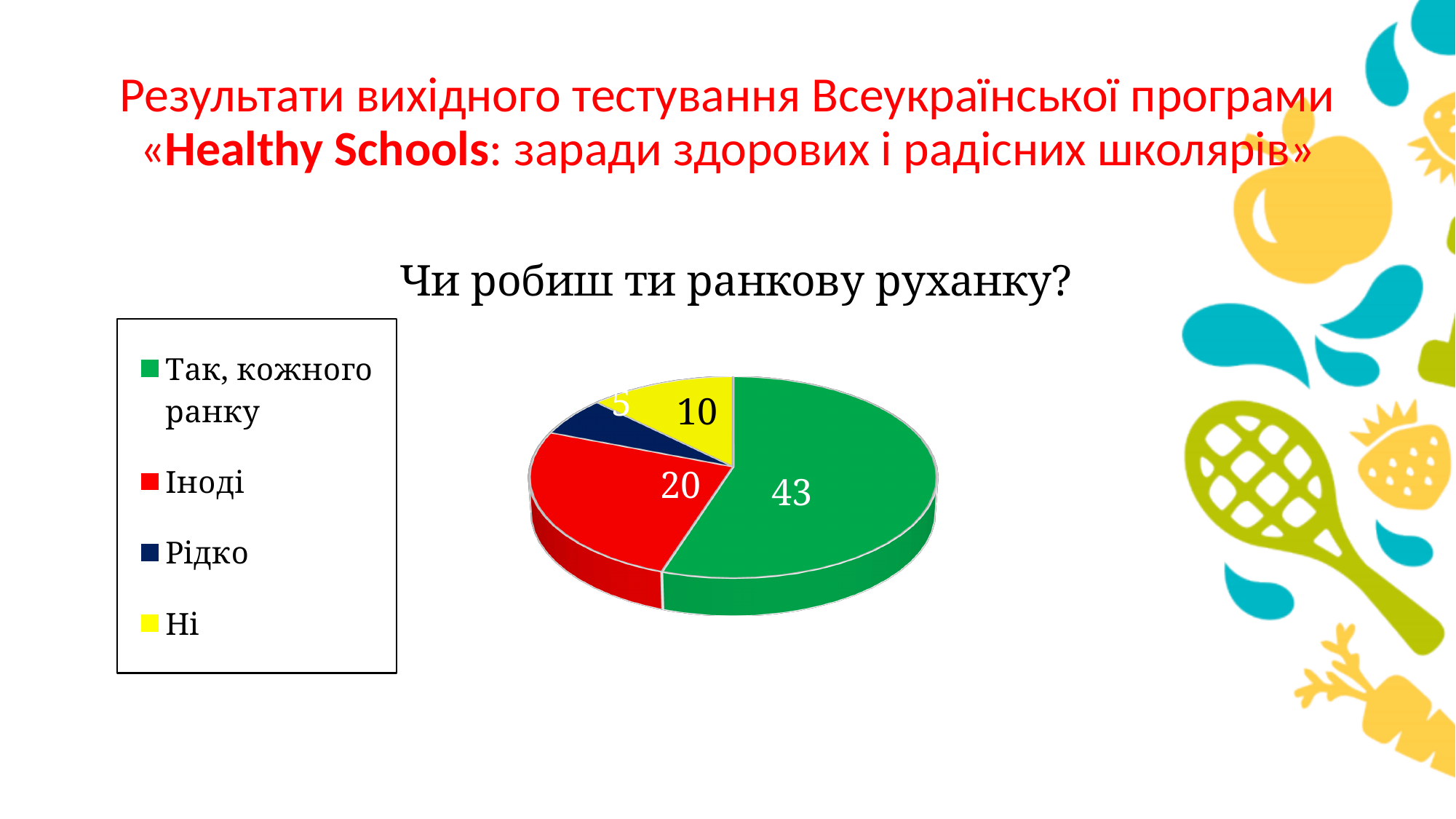
What is the title of the chart? Чи робиш ти ранкову руханку? What is the value for "Рідко" in the pie chart? 5 Which is larger, the value for "Іноді" or the value for "Ні"? Іноді What is the value for "Так, кожного ранку" in the pie chart? 43 What is the difference between the values for "Ні" and "Рідко"? 5 How many categories does the pie chart show? 4 What is the value for "Іноді" in the pie chart? 20 Which category has the smallest slice in the pie chart? Рідко Which category has the largest slice in the pie chart? Так, кожного ранку What is the difference between the values for "Так, кожного ранку" and "Іноді"? 23 What is the value for "Ні" in the pie chart? 10 What kind of chart is shown on the slide? Pie chart